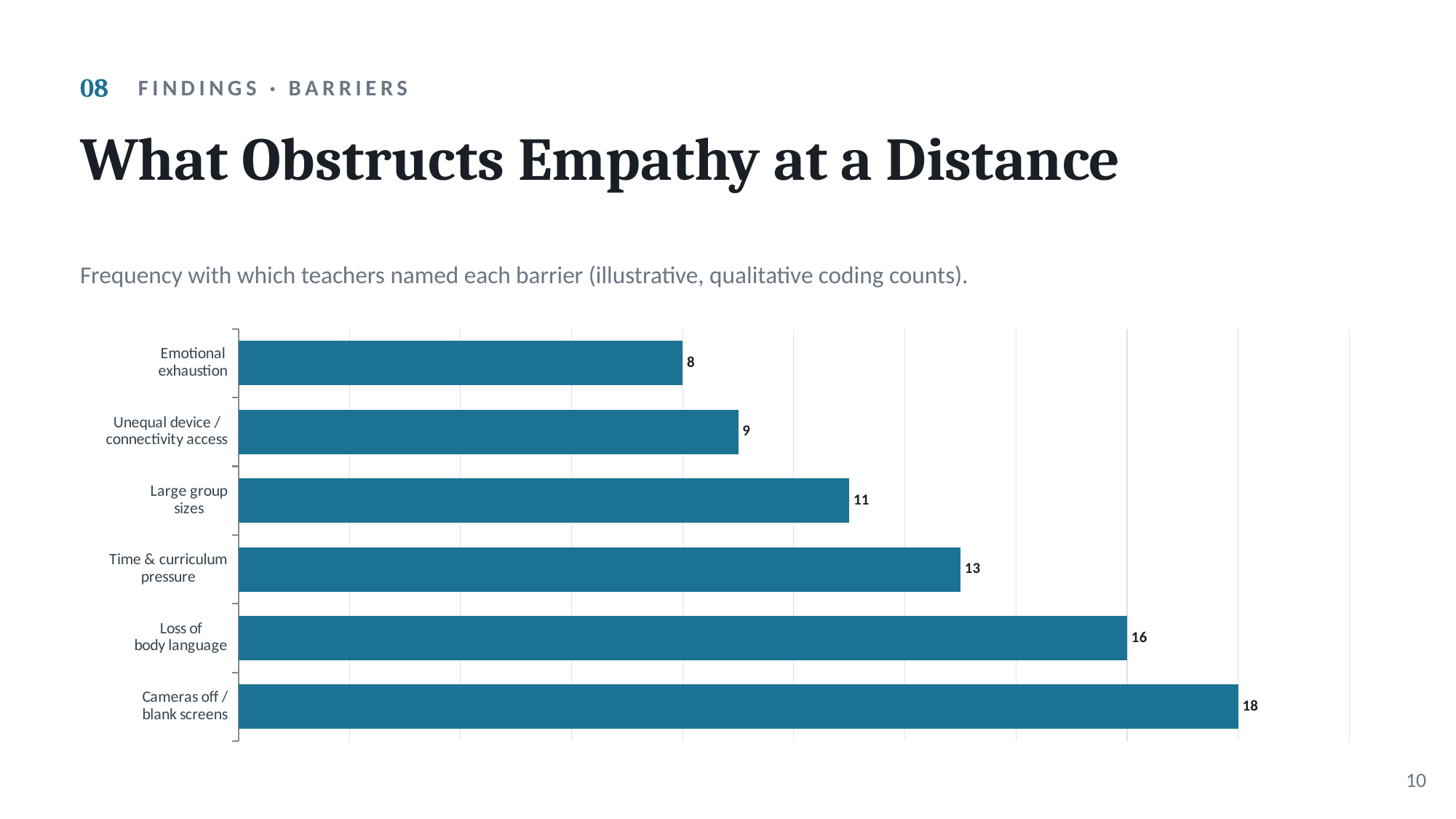
Which barrier has the lowest value? Emotional exhaustion What is the difference between the values for Cameras off / blank screens and Loss of body language? 2 What is the value for Cameras off / blank screens? 18 Which barrier has the highest value? Cameras off / blank screens What is the value for Emotional exhaustion? 8 What is the value for Loss of body language? 16 What is the value for Time & curriculum pressure? 13 What is the value for Large group sizes? 11 Which is larger, the value for Unequal device / connectivity access or the value for Large group sizes? Large group sizes How many barriers are shown in the chart? 6 What kind of chart is shown on the slide? Bar chart What is the title of the slide containing the chart? What Obstructs Empathy at a Distance